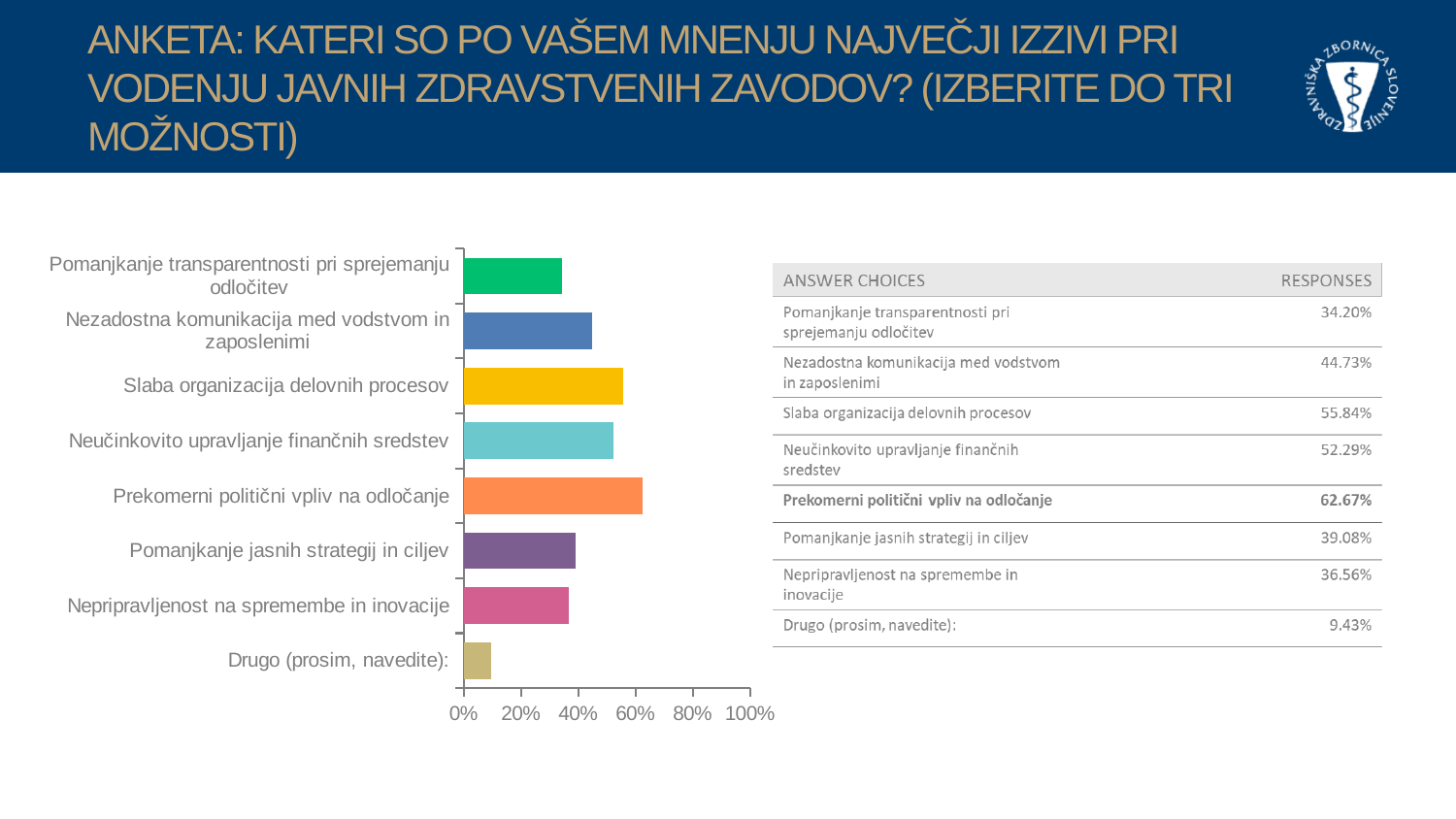
Is the value for "Neučinkovito upravljanje finančnih sredstev" greater or less than 40%? greater How many categories are shown in the chart? 8 Which is larger: the value for "Nezadostna komunikacija med vodstvom in zaposlenimi" or the value for "Pomanjkanje transparentnosti pri sprejemanju odločitev"? Nezadostna komunikacija med vodstvom in zaposlenimi What is the value for "Pomanjkanje jasnih strategij in ciljev"? 39.08% What kind of chart is shown on the slide? bar chart Which category has the lowest value? Drugo (prosim, navedite): Which category has the highest value? Prekomerni politični vpliv na odločanje What is the difference between the values for "Prekomerni politični vpliv na odločanje" and "Drugo (prosim, navedite):"? 53.24% What is the value for "Drugo (prosim, navedite):"? 9.43% What is the value for "Slaba organizacija delovnih procesov"? 55.84% What is the value for "Prekomerni politični vpliv na odločanje"? 62.67% Is the value for "Nepripravljenost na spremembe in inovacije" greater or less than 60%? less